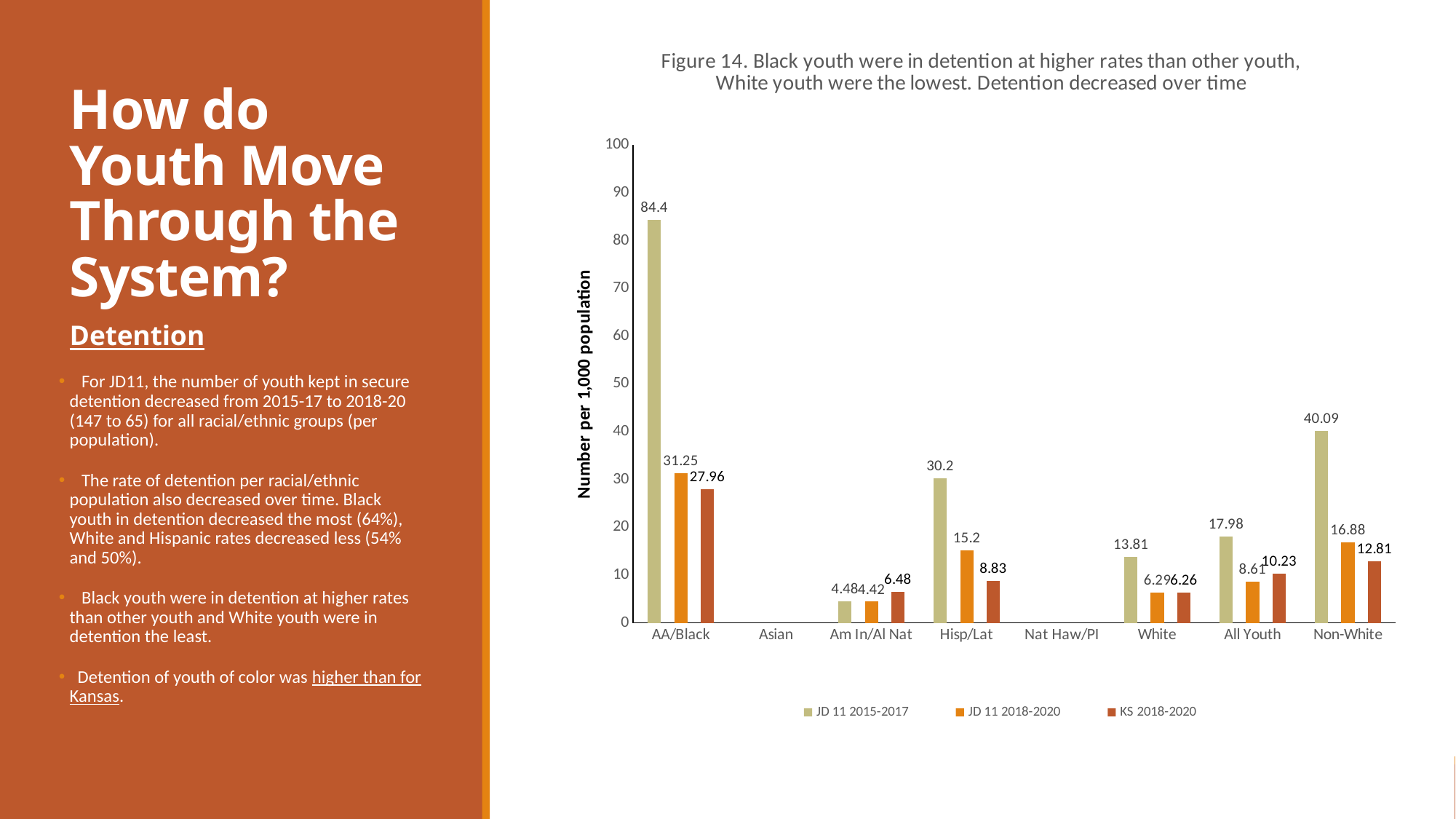
Which category has the highest JD 11 2015-2017 value? AA/Black What is the JD 11 2015-2017 value for All Youth? 17.98 Which is larger for All Youth: the JD 11 2018-2020 value or the KS 2018-2020 value? KS 2018-2020 What is the label of the vertical axis? Number per 1,000 population What is the difference between the JD 11 2015-2017 and JD 11 2018-2020 values for Hisp/Lat? 15 Among the categories with plotted bars, which has the lowest JD 11 2018-2020 value? Am In/Al Nat What is the KS 2018-2020 value for Hisp/Lat? 8.83 What kind of chart is shown on the slide? Bar chart How many series does the legend list? 3 What is the JD 11 2018-2020 value for Non-White? 16.88 How many categories are shown on the x axis? 8 What is the JD 11 2015-2017 value for AA/Black? 84.4